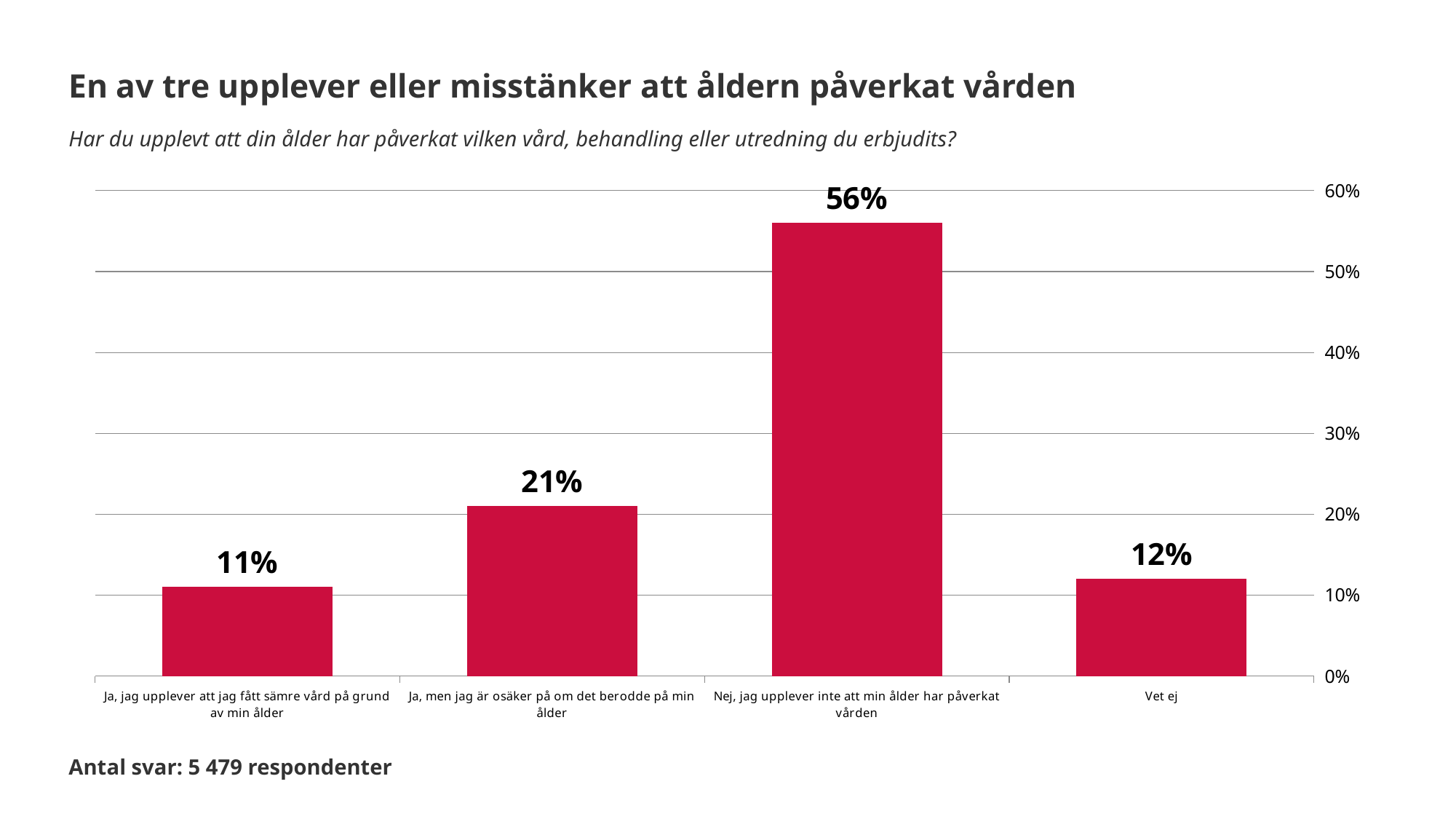
What is the value for "Ja, jag upplever att jag fått sämre vård på grund av min ålder"? 11% What is the value for "Ja, men jag är osäker på om det berodde på min ålder"? 21% What is the difference between the "Nej, jag upplever inte att min ålder har påverkat vården" bar and the "Ja, men jag är osäker på om det berodde på min ålder" bar? 35 percentage points What type of chart is shown on the slide? bar chart How many response categories are shown in the chart? 4 What is the combined value of the two "Ja" categories? 32% What percentage of respondents answered "Vet ej"? 12% Which response category has the highest value? Nej, jag upplever inte att min ålder har påverkat vården Is the value for "Nej, jag upplever inte att min ålder har påverkat vården" greater or less than 50%? greater How many respondents answered the survey, according to the slide? 5 479 respondenter Which response category has the lowest value? Ja, jag upplever att jag fått sämre vård på grund av min ålder Which is larger: the value for "Vet ej" or the value for "Ja, jag upplever att jag fått sämre vård på grund av min ålder"? Vet ej